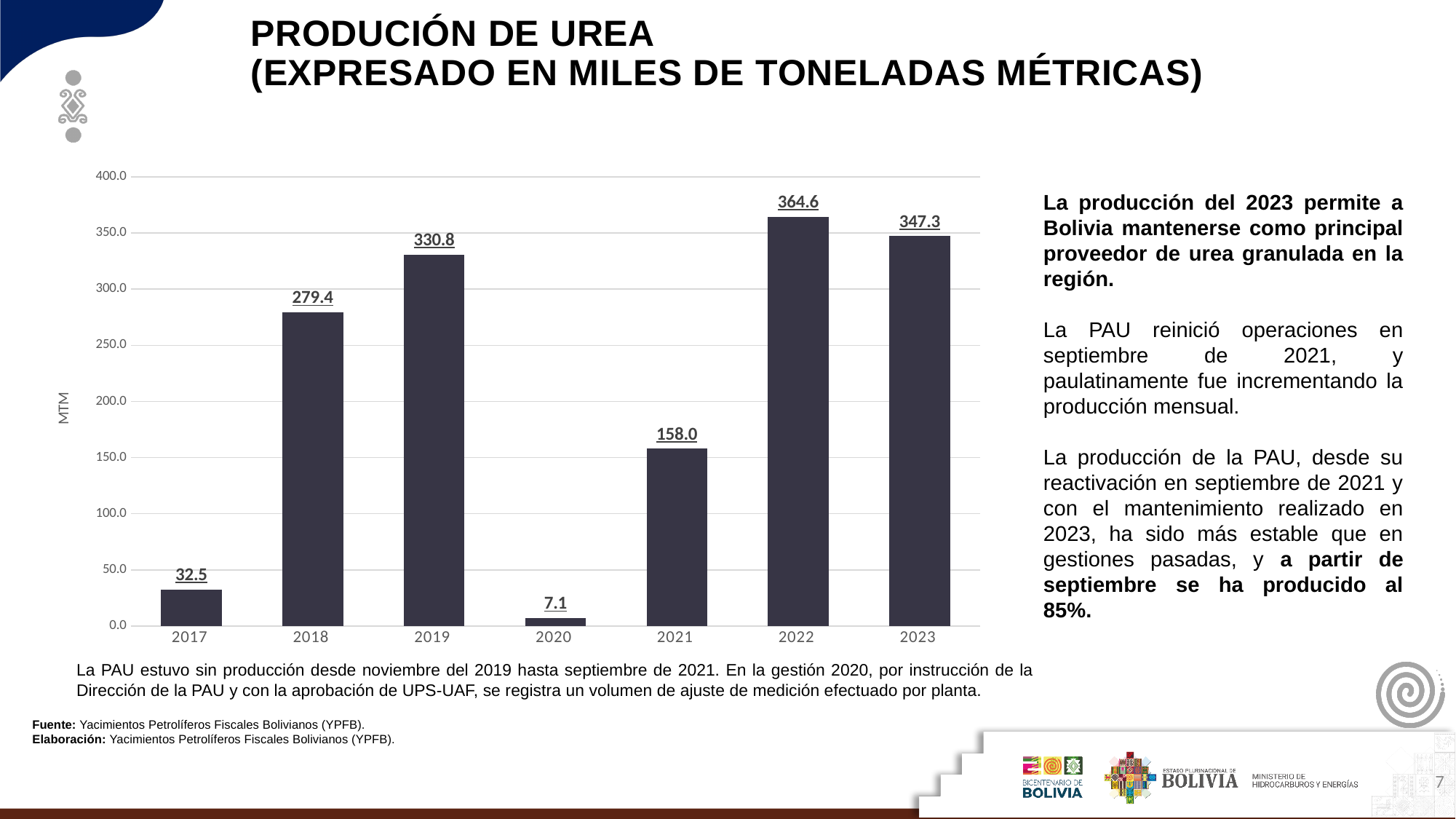
What kind of chart is shown on the slide? bar chart What is the urea production value shown for 2021? 158.0 Which year has the highest urea production in the chart? 2022 What is the difference between the 2022 and 2023 production values? 17.3 How many years are shown on the x axis of the chart? 7 Which year has a larger production value, 2018 or 2019? 2019 Which year has the lowest urea production in the chart? 2020 Is the value for 2021 greater or less than 200.0? less What is the label on the vertical axis of the chart? MTM What is the urea production value shown for 2017? 32.5 What is the difference between the 2018 and 2017 production values? 246.9 What is the urea production value shown for 2019? 330.8